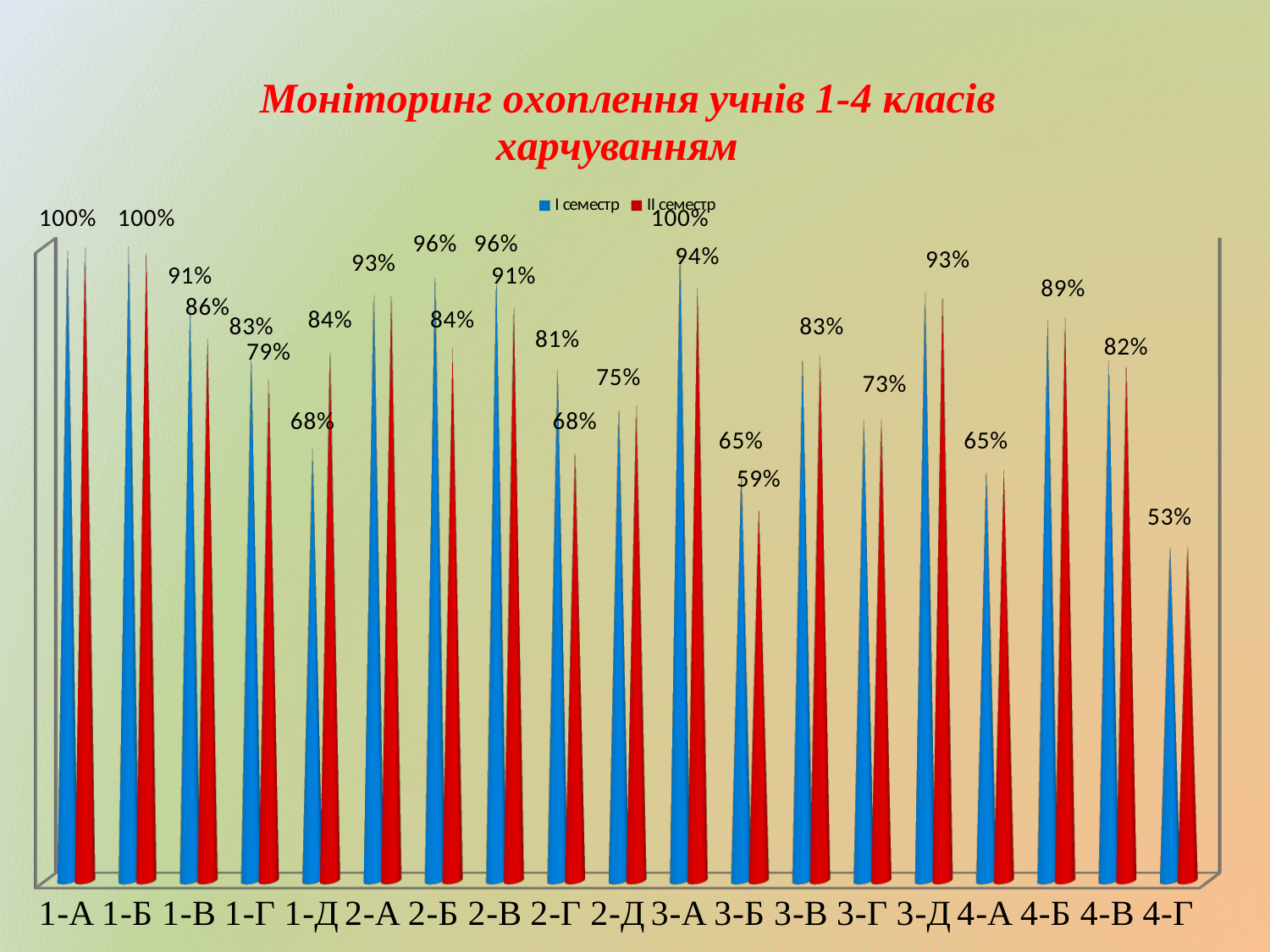
What is the I семестр value for class 1-В? 91% What is the value shown for class 3-Д? 93% How many class categories are shown along the x axis? 19 What is the value shown for class 4-Г? 53% Which class has the lowest value on the chart? 4-Г How many series does the legend list? 2 What kind of chart is shown on the slide? bar chart Which is larger: the value for class 1-А or the value for class 4-Г? 1-А Which colour represents the II семестр series? red What is the II семестр value for class 3-Б? 59% What is the difference between the I семестр and II семестр values for class 1-В? 5% What is the title of the chart? Моніторинг охоплення учнів 1-4 класів харчуванням